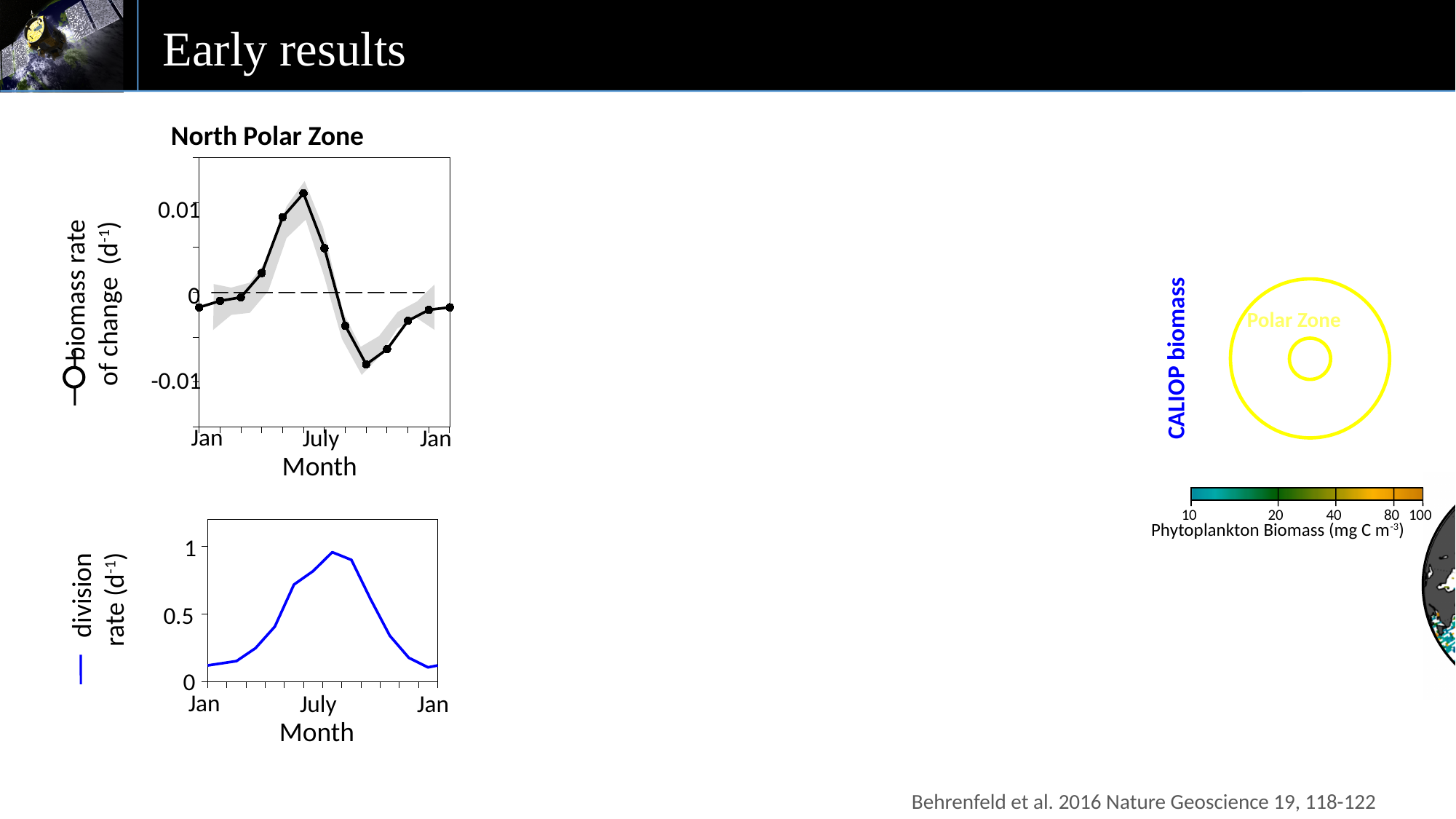
On the bottom division rate chart, is the peak division rate greater or less than 0.5? greater On the bottom division rate chart, is the division rate in January greater or less than 0.5? less On the top 'North Polar Zone' chart, is the peak biomass rate of change greater or less than 0.01? greater On the bottom division rate chart, does the division rate rise or fall from July to the following January? fall What kind of chart is the top chart titled 'North Polar Zone'? line chart What is the title of the top chart? North Polar Zone What kind of chart is the bottom chart showing division rate? line chart What is the x-axis label on the bottom division rate chart? Month On the bottom division rate chart, does the division rate rise or fall from January to July? rise How many data points are plotted on the top 'North Polar Zone' biomass rate of change chart? 13